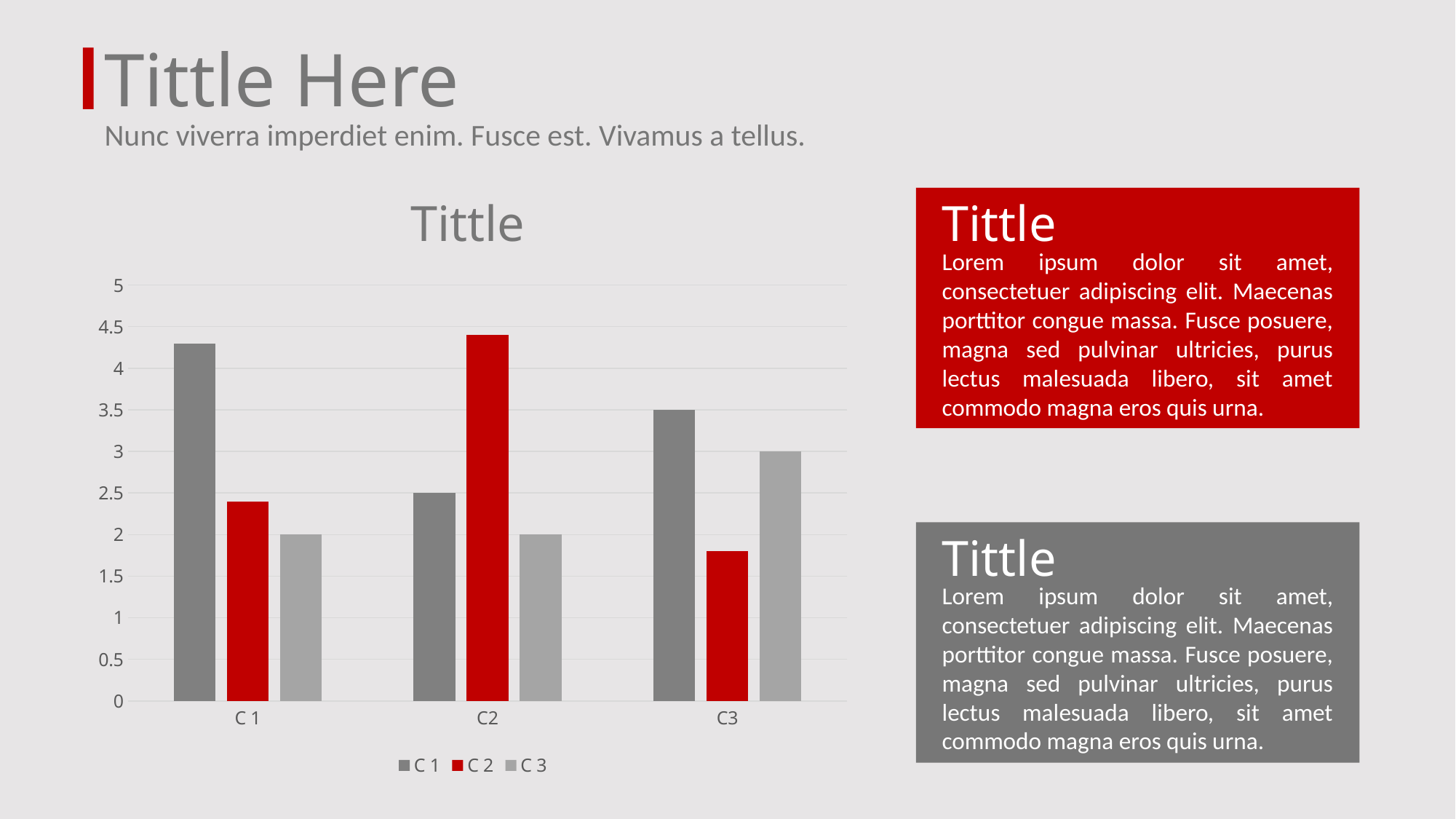
Which series has the highest value in category C2? C 2 How many series does the chart legend list? 3 Which series has the lowest value in category C3? C 2 How many categories are shown on the x axis of the chart? 3 What is the value of series C 3 for category C3? 3 Is the value of series C 2 for category C2 greater or less than 4? greater What is the value of series C 3 for category C 1? 2 What is the title of the chart? Tittle Which is larger: series C 1 in category C 1 or series C 1 in category C2? C 1 in category C 1 What kind of chart is shown on the slide? bar chart Is the value of series C 2 for category C3 greater or less than 2? less What is the value of series C 1 for category C3? 3.5